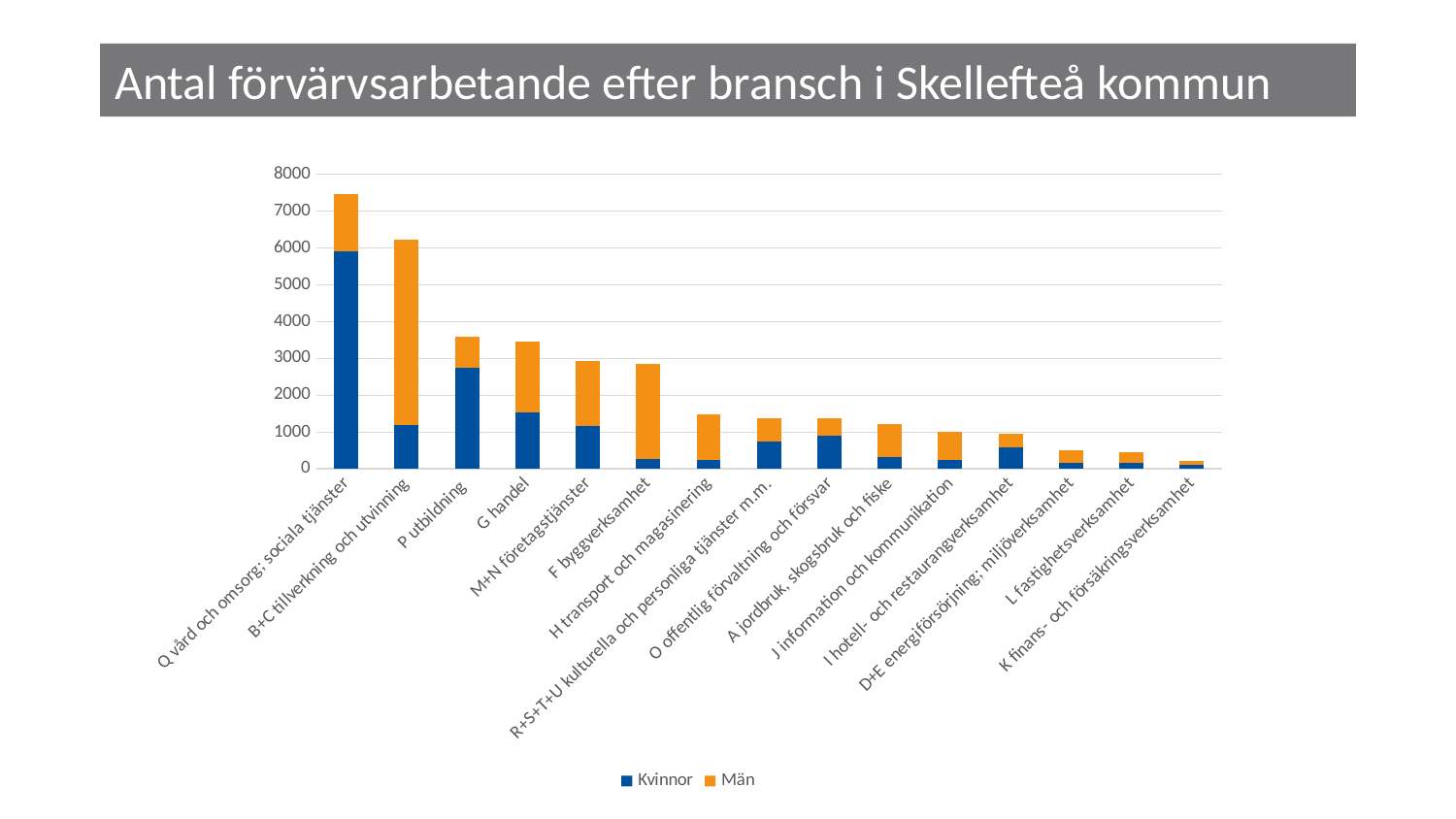
Which category has the lowest total number of employed persons? K finans- och försäkringsverksamhet Which category has the highest total number of employed persons? Q vård och omsorg; sociala tjänster Is the total value for Q vård och omsorg; sociala tjänster greater or less than 7000? greater What kind of chart is shown on the slide? Stacked bar chart How many industry categories are shown on the x axis? 15 Which category has the larger Män segment: B+C tillverkning och utvinning or Q vård och omsorg; sociala tjänster? B+C tillverkning och utvinning Is the Kvinnor value for Q vård och omsorg; sociala tjänster greater or less than 5000? greater Do the total bar heights rise or fall from left to right along the x axis? Fall What is the title of the chart? Antal förvärvsarbetande efter bransch i Skellefteå kommun How many series does the legend list? 2 Which colour represents the Män series in the legend? Orange